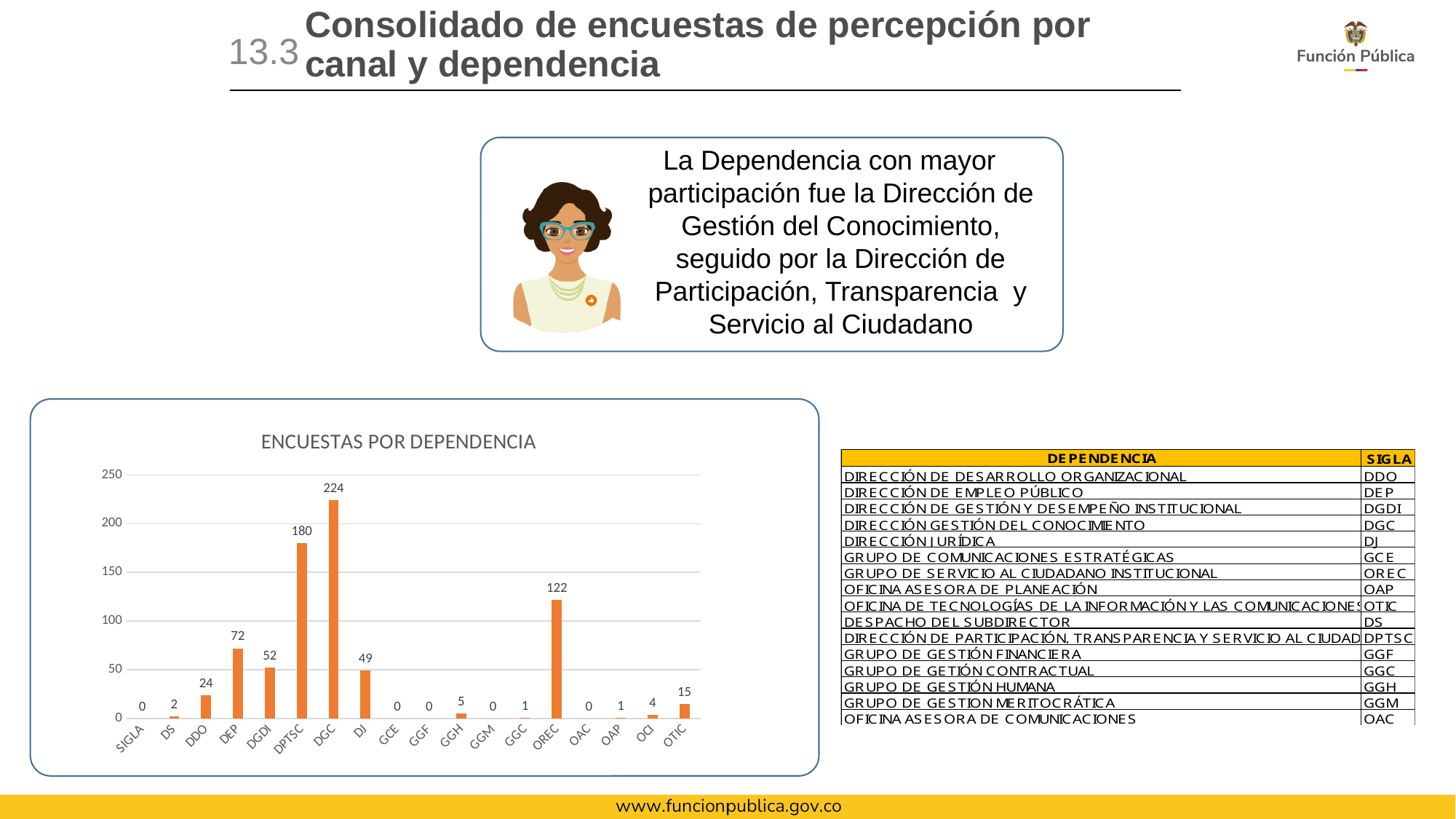
What is the difference between the values for DEP and DGDI in the ENCUESTAS POR DEPENDENCIA chart? 20 What is the value for DGC in the ENCUESTAS POR DEPENDENCIA chart? 224 Which is larger in the ENCUESTAS POR DEPENDENCIA chart, the value for DDO or the value for DJ? DJ How many categories are shown on the x axis of the ENCUESTAS POR DEPENDENCIA chart? 18 What is the value for OTIC in the ENCUESTAS POR DEPENDENCIA chart? 15 What kind of chart is the ENCUESTAS POR DEPENDENCIA chart? bar chart Is the value for OREC greater or less than 100 in the ENCUESTAS POR DEPENDENCIA chart? greater What is the value for DPTSC in the ENCUESTAS POR DEPENDENCIA chart? 180 What is the value for OREC in the ENCUESTAS POR DEPENDENCIA chart? 122 What is the difference between the values for DGC and DPTSC in the ENCUESTAS POR DEPENDENCIA chart? 44 What is the title of the chart on the slide? ENCUESTAS POR DEPENDENCIA Which category has the highest value in the ENCUESTAS POR DEPENDENCIA chart? DGC